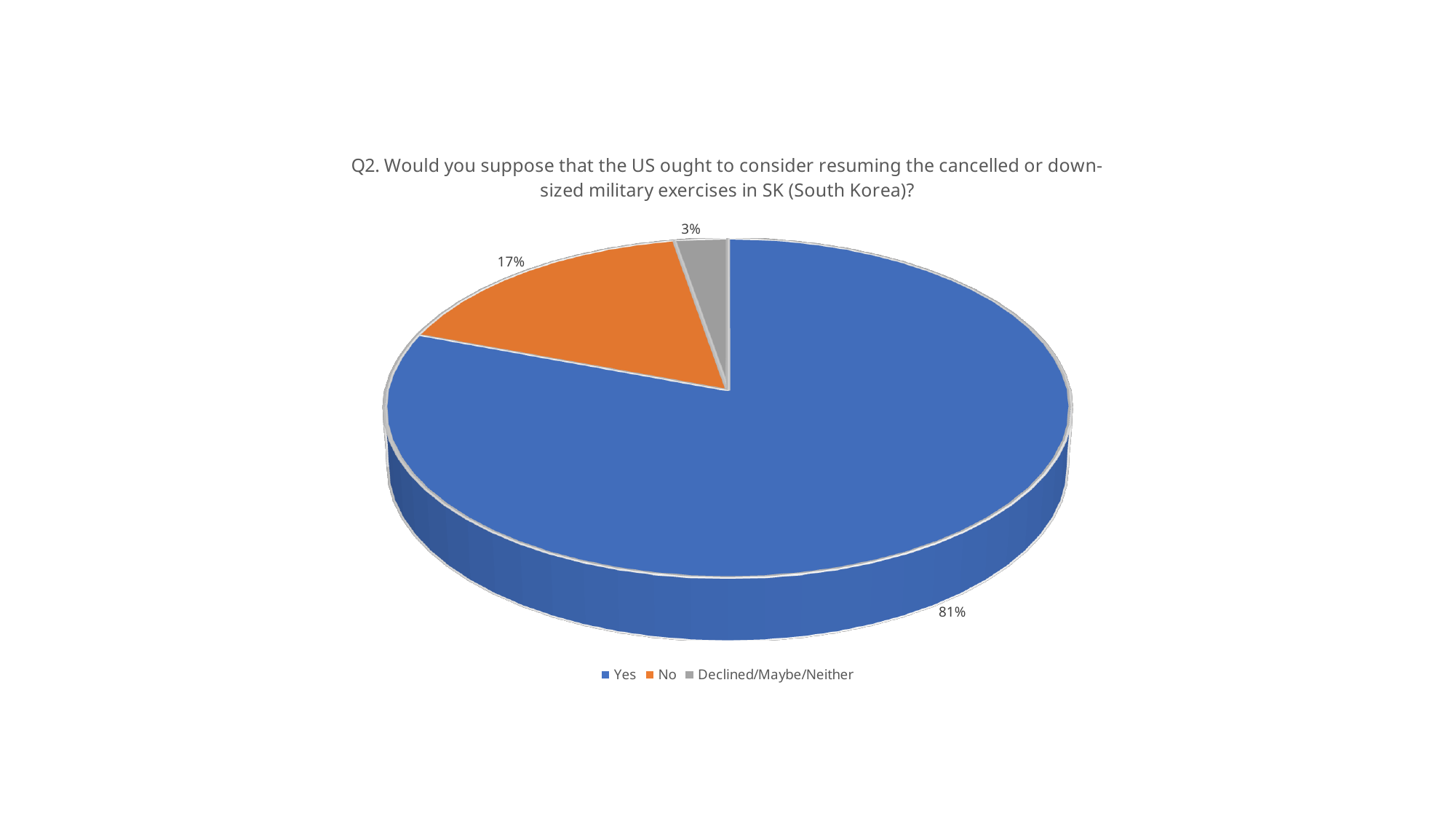
What is the difference in percentage points between the Yes and No slices? 64 What colour is the Yes slice? Blue What kind of chart is shown on the slide? Pie chart Which response has the smallest slice of the pie? Declined/Maybe/Neither What share of respondents fell into Declined/Maybe/Neither? 3% What colour is the No slice? Orange How many slices does the pie chart have? 3 What share of respondents answered No? 17% Which is larger, the No slice or the Declined/Maybe/Neither slice? No Which response has the largest slice of the pie? Yes What share of respondents answered Yes? 81% What is the difference in percentage points between the No and Declined/Maybe/Neither slices? 14